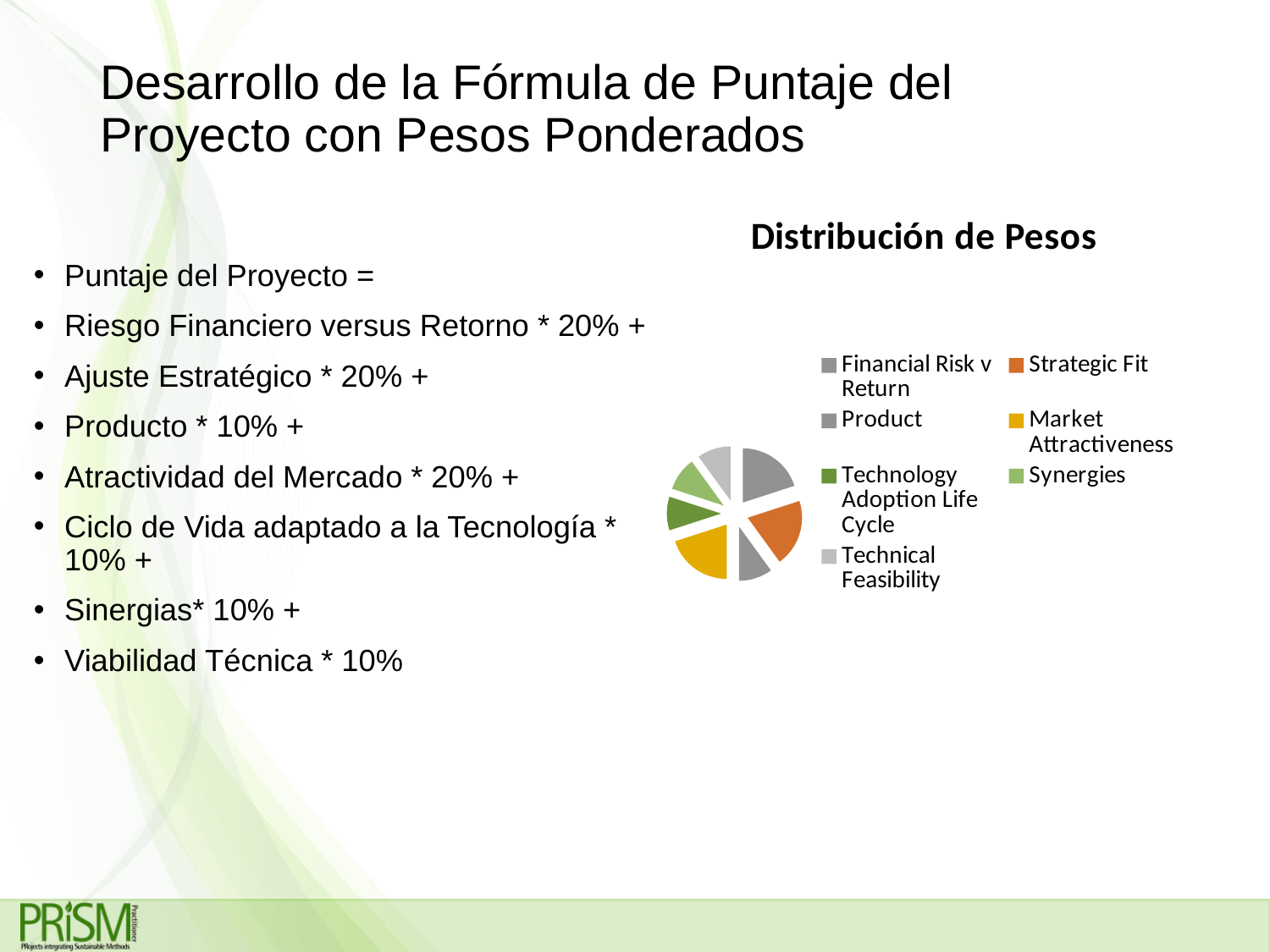
In the pie chart, which slice is larger: Market Attractiveness or Product? Market Attractiveness Which colour represents Strategic Fit in the pie chart? orange How many slices does the pie chart have? 7 In the pie chart, which slice is larger: Strategic Fit or Synergies? Strategic Fit In the pie chart, which slice is larger: Technical Feasibility or Financial Risk v Return? Financial Risk v Return What is the title of the chart on the slide? Distribución de Pesos How many categories does the legend of the pie chart list? 7 What kind of chart is shown on the slide? pie chart